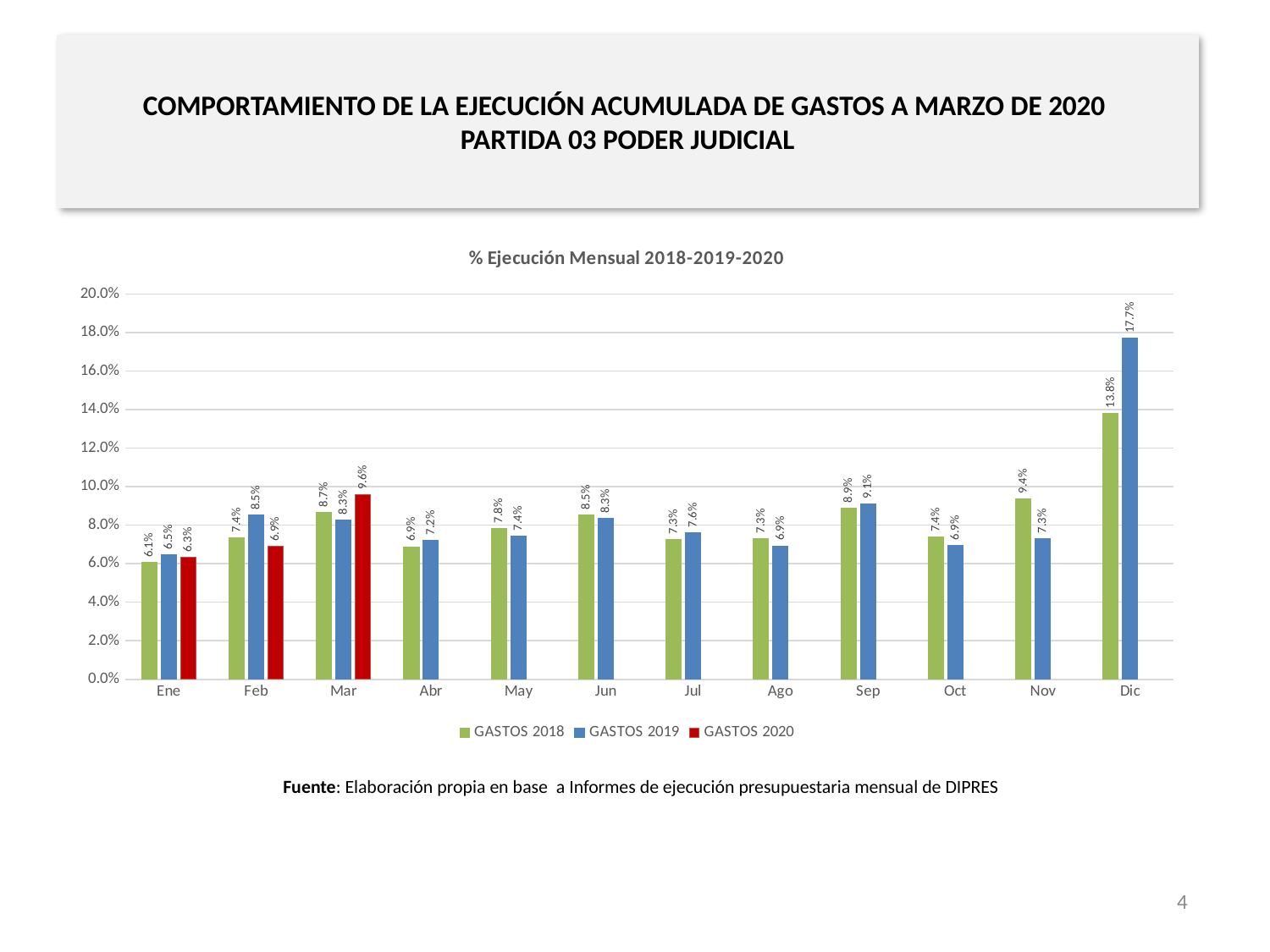
What is the value for GASTOS 2020 in Mar? 9.6% Which is larger in Feb, GASTOS 2019 or GASTOS 2020? GASTOS 2019 What is the value for GASTOS 2018 in Nov? 9.4% How many series does the legend list? 3 How many months are shown on the x axis? 12 Is the value for GASTOS 2019 in Dic greater or less than 16.0%? greater What is the difference between GASTOS 2019 and GASTOS 2018 in Dic? 3.9% What kind of chart is shown on the slide? Bar chart What is the title of the chart? % Ejecución Mensual 2018-2019-2020 Which month has the highest value for GASTOS 2018? Dic Which month has the lowest value for GASTOS 2018? Ene What is the value for GASTOS 2019 in Dic? 17.7%